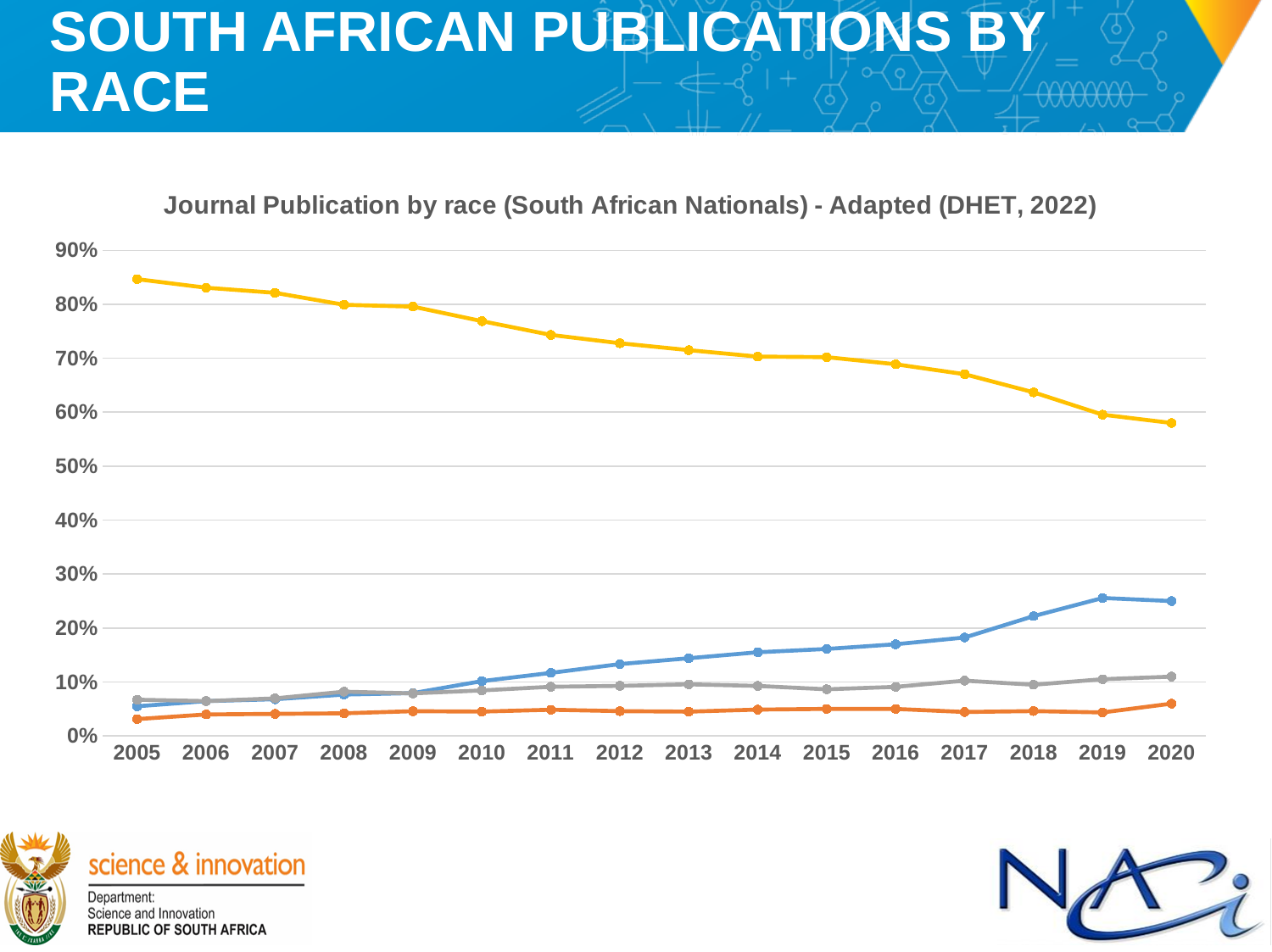
How many lines are plotted on the chart? 4 Is the value of the yellow line in 2020 greater or less than 60%? less Is the value of the yellow line in 2005 greater or less than 80%? greater In which year is the yellow line at its highest? 2005 Does the blue line rise or fall from 2005 to 2020? rise How many years are shown along the x axis of the chart? 16 Is the value of the blue line in 2019 greater or less than 20%? greater Does the yellow line rise or fall from 2005 to 2020? fall What kind of chart is shown on the slide? line chart In which year is the yellow line at its lowest? 2020 In 2020, which line has the larger value, the blue line or the grey line? blue line What is the title of the chart? Journal Publication by race (South African Nationals) - Adapted (DHET, 2022)